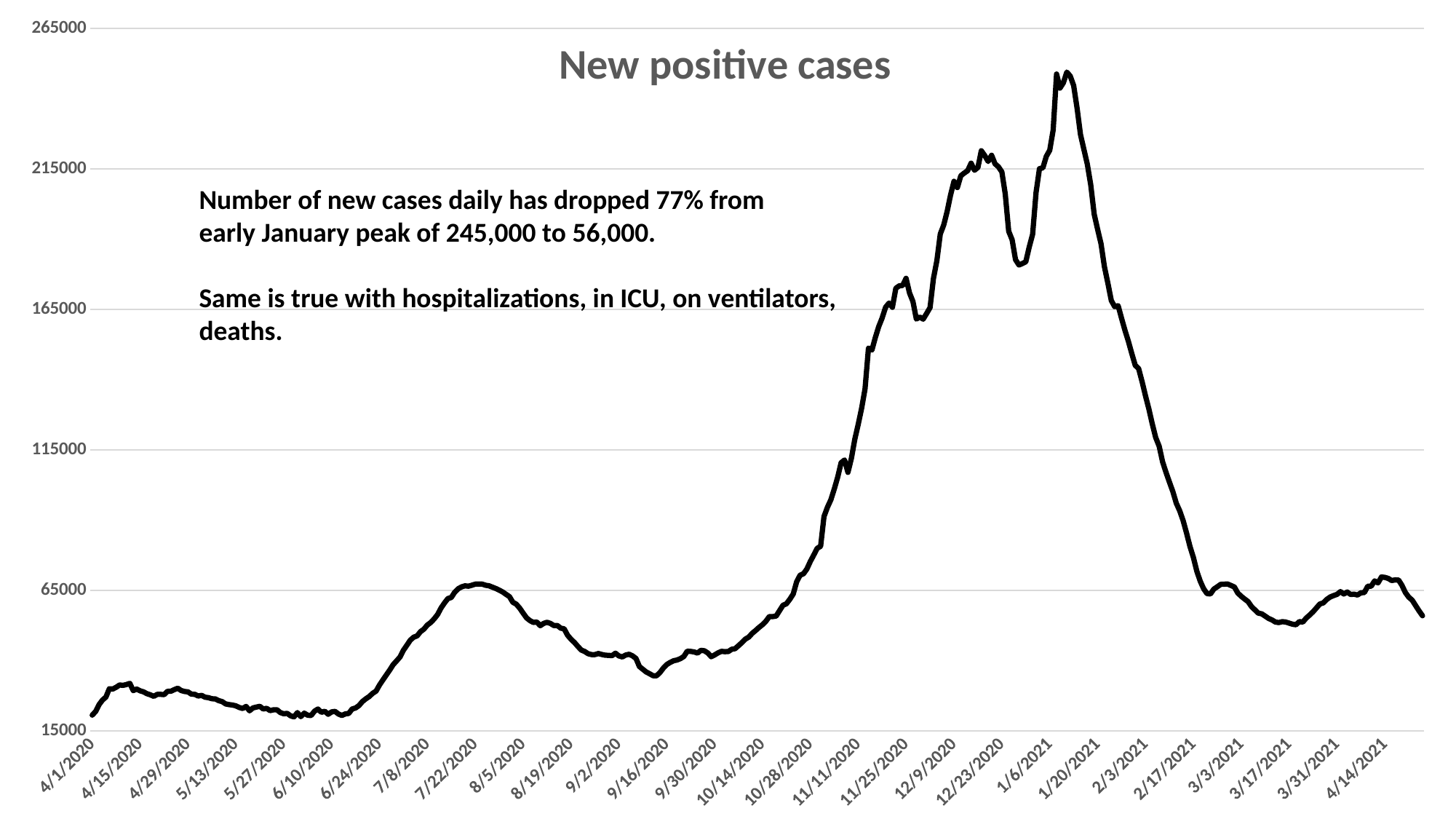
What kind of chart is shown on the slide? line chart How many date labels are shown along the x axis? 28 Is the value for 4/1/2020 greater or less than 65000? less Which is larger, the value for 1/6/2021 or the value for 7/22/2020? 1/6/2021 According to the text on the slide, what was the early January peak in daily new cases? 245,000 Is the value for 12/9/2020 greater or less than 165000? greater In which month does the line reach its highest point? January 2021 What is the title of the chart? New positive cases Is the value for 9/16/2020 greater or less than 65000? less Does the line rise or fall between 1/6/2021 and 3/3/2021? fall Does the line rise or fall between 9/16/2020 and 12/9/2020? rise